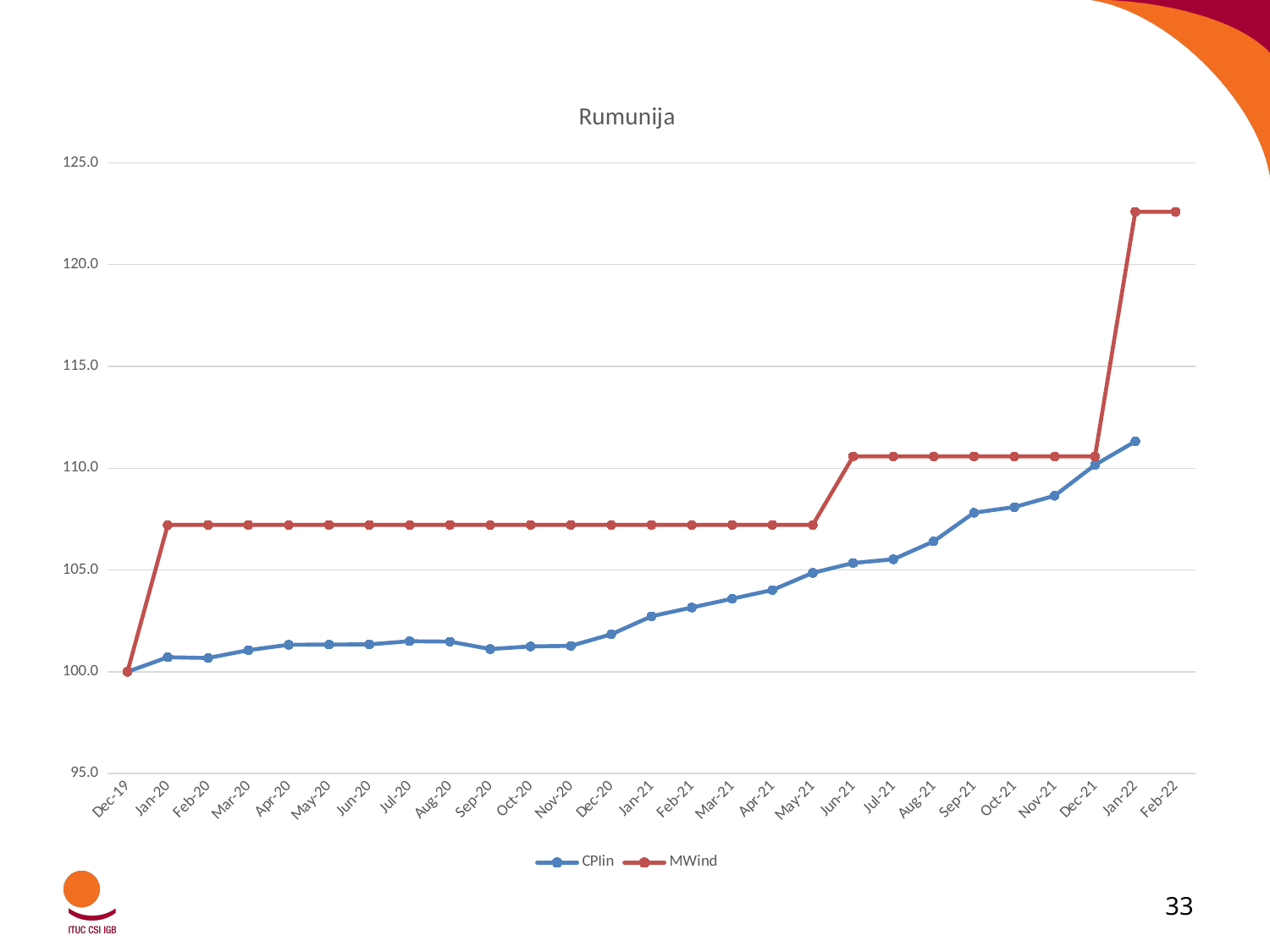
What is the title of the chart? Rumunija In which month does CPIin reach its highest value? Jan-22 Which series has the higher value in Feb-21, CPIin or MWind? MWind What is the value of MWind in Dec-19? 100.0 How many months are shown on the x axis? 27 How many series does the legend list? 2 Do the CPIin values generally rise or fall from Dec-19 to Jan-22? Rise Is the value for CPIin in Jun-21 greater or less than 110? less What type of chart is shown on the slide? Line chart Is the value for MWind in Feb-22 greater or less than 120? greater Is the value for MWind in Jan-20 greater or less than 105? greater What is the value of CPIin in Dec-19? 100.0